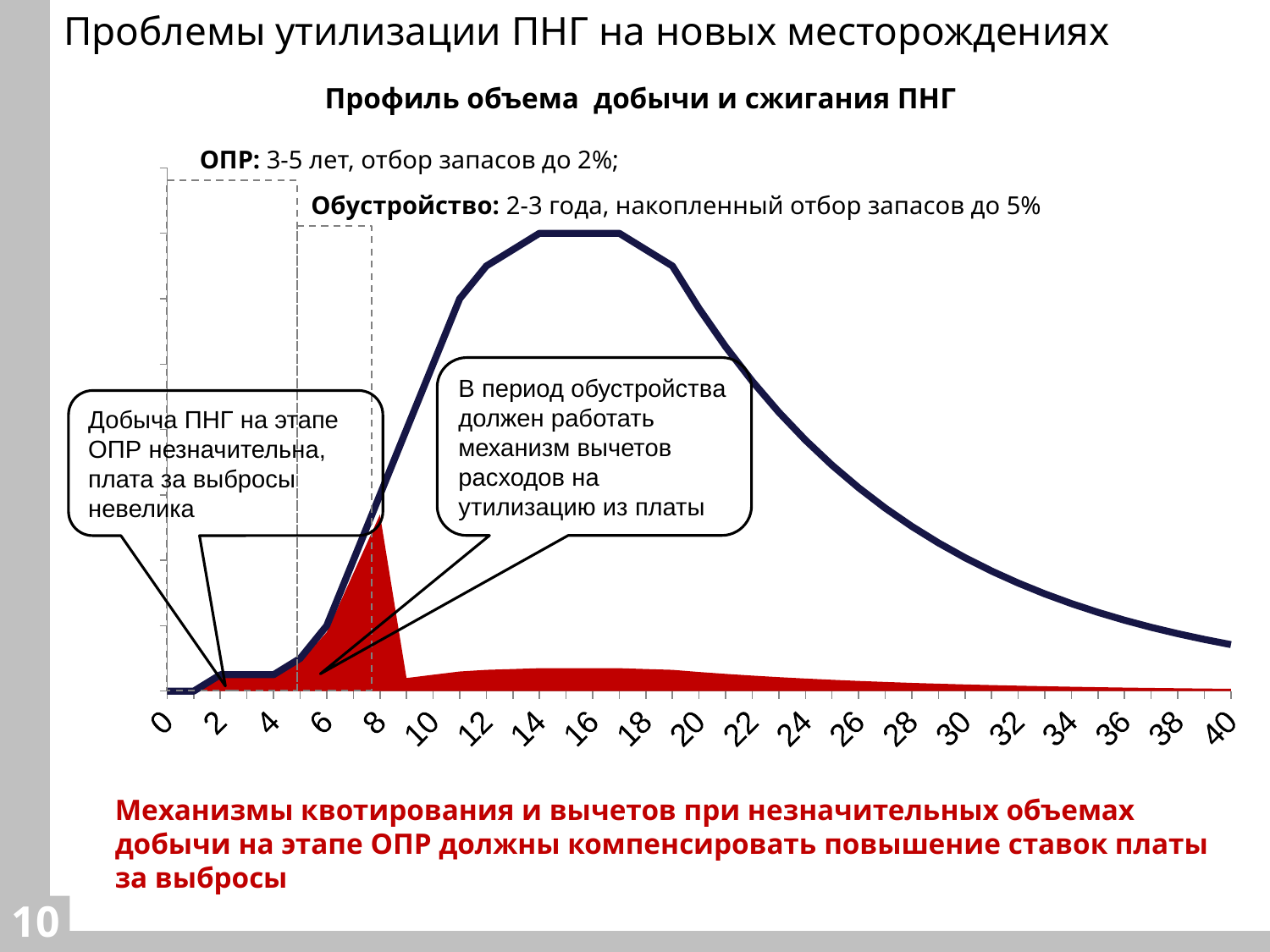
What is the highest value shown on the x axis of the chart? 40 Is the red filled area taller at x = 8 or at x = 20? x = 8 What colour is the line showing the production profile on the chart? dark navy blue What is the title of the chart on the slide? Профиль объема добычи и сжигания ПНГ Does the dark line rise or fall between x = 4 and x = 14? rises What kind of chart is shown on the slide? line chart with a filled area How many tick labels are shown on the x axis of the chart? 21 Does the red filled area rise or fall between x = 8 and x = 10? falls Is the dark line higher at x = 16 or at x = 40? x = 16 Does the dark line rise or fall between x = 20 and x = 40? falls Is the dark line higher at x = 2 or at x = 12? x = 12